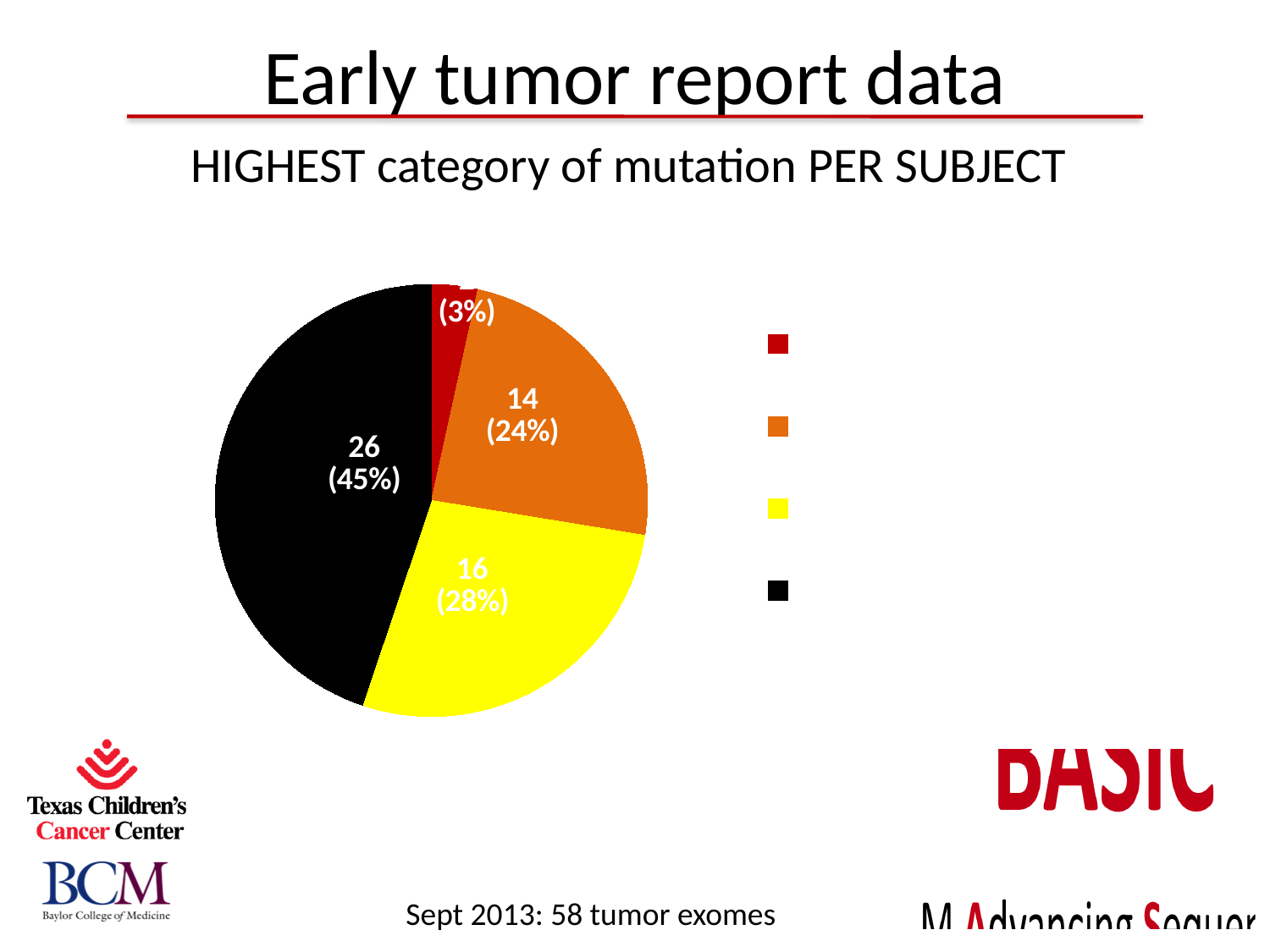
How many entries does the legend of the pie chart list? 4 What value is printed on the yellow slice of the pie chart? 16 What percentage share does the black slice of the pie chart represent? 45% Which colour slice is the smallest in the pie chart? red What value is printed on the orange slice of the pie chart? 14 What is the subtitle printed above the pie chart? HIGHEST category of mutation PER SUBJECT What kind of chart is shown on the slide? pie chart What is the difference between the values of the black slice and the yellow slice? 10 Which colour slice is the largest in the pie chart? black What percentage share does the red slice of the pie chart represent? 3% How many slices does the pie chart have? 4 What value is printed on the black slice of the pie chart? 26